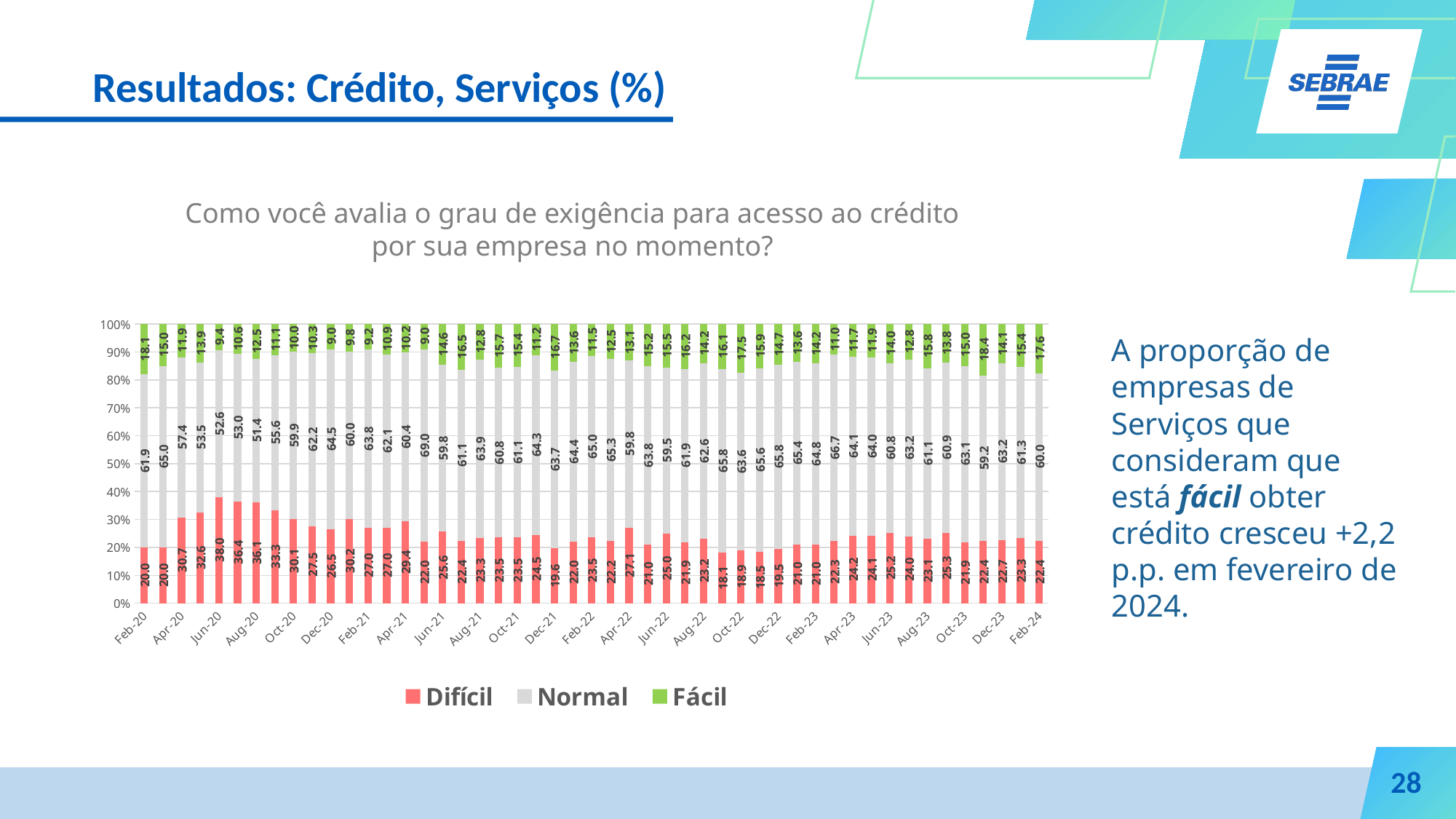
Is the Difícil value for Jun-20 greater or less than 30%? greater What is the Difícil value for Jun-20? 38.0 Which legend entry is shown in green? Fácil How many series does the legend list? 3 What is the Normal value for Feb-20? 61.9 In which month is the Difícil value highest? Jun-20 What is the Fácil value for Feb-24? 17.6 What is the difference between the Difícil value in Jun-20 and in Feb-20? 18.0 Which is larger, the Fácil value for Feb-20 or for Feb-24? Feb-20 What is the Difícil value for Feb-24? 22.4 What kind of chart is shown on the slide? Stacked bar chart Does the Difícil value rise or fall from Feb-20 to Jun-20? Rise